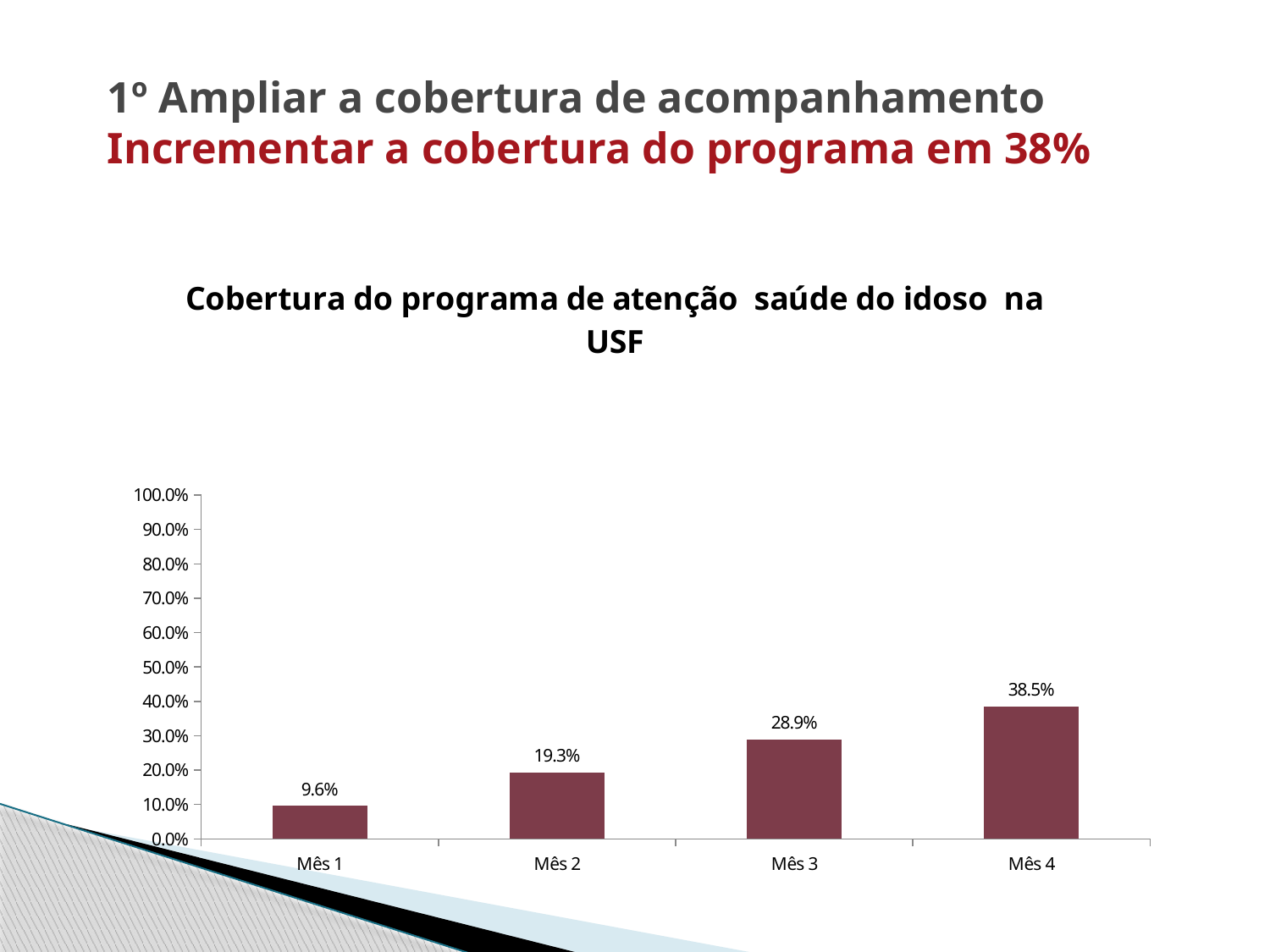
Which month has the highest coverage value? Mês 4 What is the value for Mês 1? 9.6% What kind of chart is shown on the slide? Bar chart Do the values rise or fall from Mês 1 to Mês 4? Rise How many months are shown on the x axis? 4 What is the difference between the values for Mês 4 and Mês 1? 28.9% What is the value for Mês 4? 38.5% Which is larger, the value for Mês 2 or the value for Mês 3? Mês 3 What is the difference between the values for Mês 3 and Mês 2? 9.6% Is the value for Mês 4 greater or less than 30.0%? greater What is the value for Mês 3? 28.9% Which month has the lowest coverage value? Mês 1